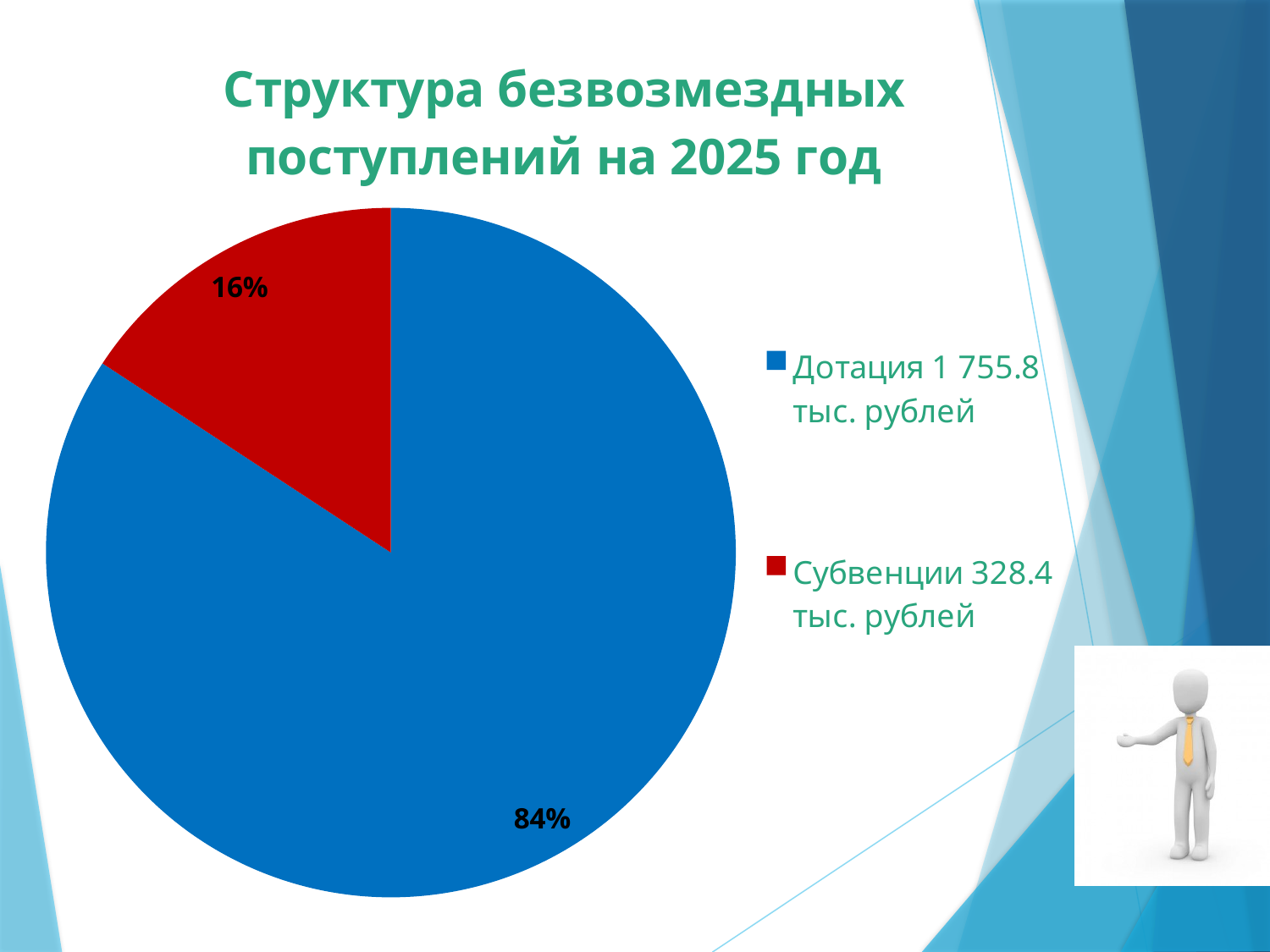
Which is larger, the Дотация slice or the Субвенции slice? Дотация What amount in thousand rubles does the legend give for Субвенции? 328.4 тыс. рублей What share of the pie does the Дотация slice represent? 84% What amount in thousand rubles does the legend give for Дотация? 1 755.8 тыс. рублей What colour is the Субвенции slice? red What share of the pie does the Субвенции slice represent? 16% Which category has the largest slice of the pie? Дотация What is the difference in percentage points between the Дотация and Субвенции slices? 68 How many entries does the legend list? 2 What kind of chart is shown on the slide? pie chart How many slices does the pie chart have? 2 Which category has the smallest slice of the pie? Субвенции